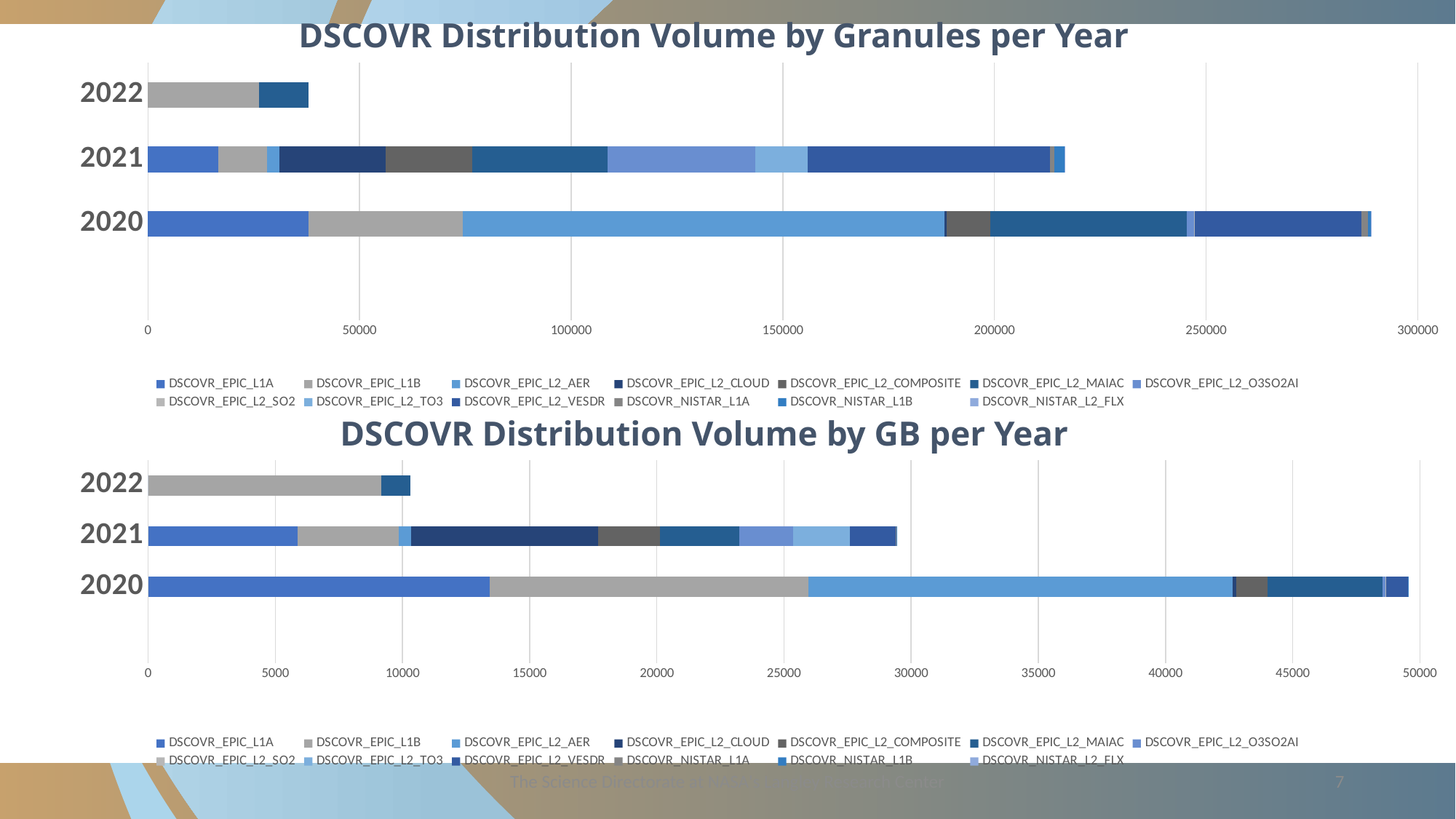
In the 'DSCOVR Distribution Volume by GB per Year' chart, which total bar is longer, 2021 or 2022? 2021 In the 'DSCOVR Distribution Volume by Granules per Year' chart, is the total bar for 2020 greater or less than 250000? greater What kind of chart is the 'DSCOVR Distribution Volume by Granules per Year' chart? Stacked bar chart What is the title of the lower chart on the slide? DSCOVR Distribution Volume by GB per Year In the 'DSCOVR Distribution Volume by GB per Year' chart, is the total bar for 2020 greater or less than 45000? greater How many series does the legend of the 'DSCOVR Distribution Volume by Granules per Year' chart list? 13 In the 'DSCOVR Distribution Volume by GB per Year' chart, which year has the shortest total bar? 2022 How many years are shown on the 'DSCOVR Distribution Volume by GB per Year' chart? 3 In the 'DSCOVR Distribution Volume by GB per Year' chart, is the total bar for 2021 greater or less than 30000? less In the 'DSCOVR Distribution Volume by Granules per Year' chart, do the total bars rise or fall from 2020 to 2022? fall In the 'DSCOVR Distribution Volume by Granules per Year' chart, which year has the longest total bar? 2020